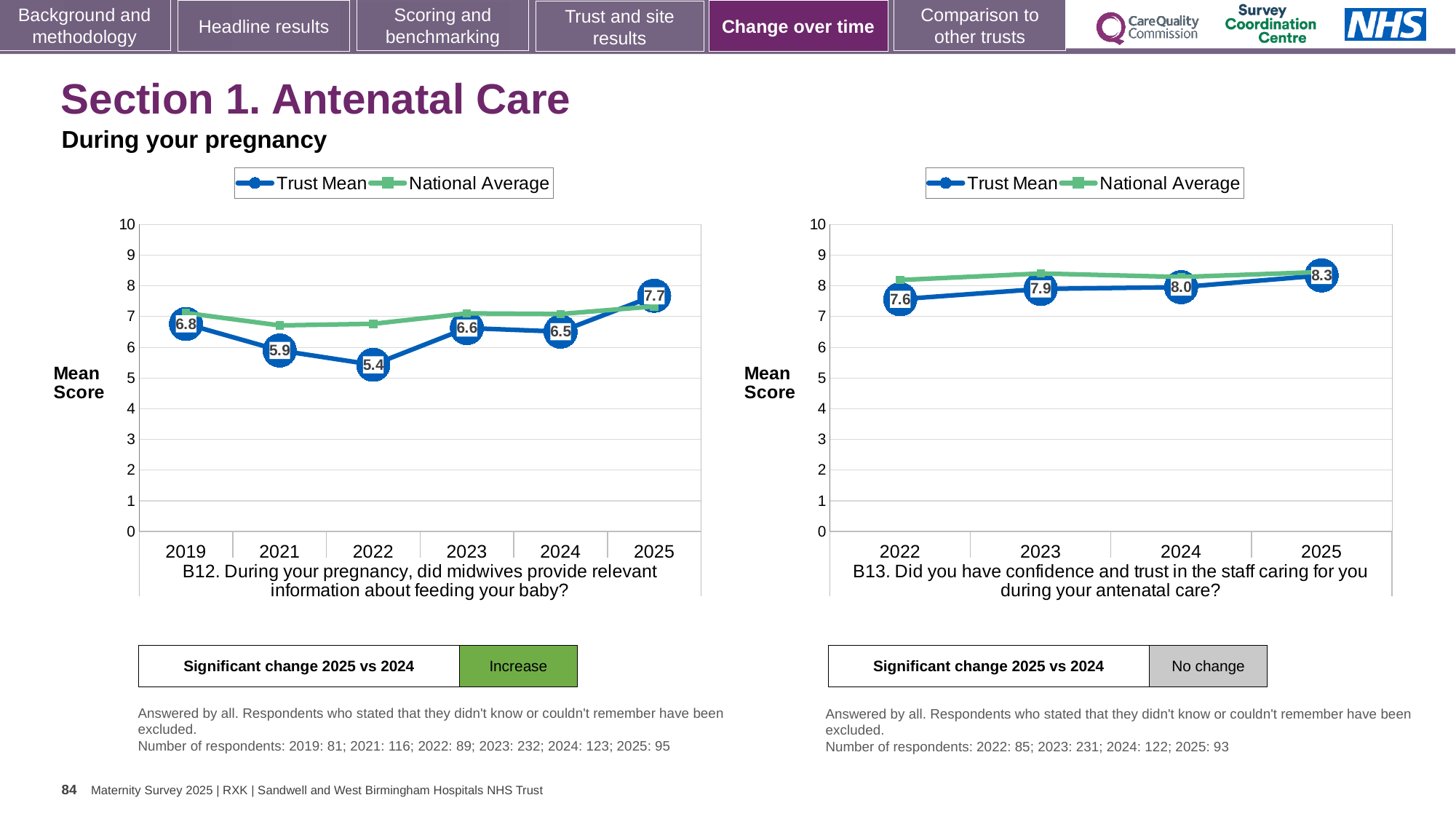
In the B12 chart (left), which year has the lowest Trust Mean score? 2022 How many series does the legend of the B13 chart (right) list? 2 In the B12 chart (left), what is the Trust Mean score for 2022? 5.4 In the B13 chart (right), what is the difference between the Trust Mean scores for 2025 and 2022? 0.7 How many years are plotted on the x axis of the B12 chart (left)? 6 In the B13 chart (right), which year has the highest Trust Mean score? 2025 What type of chart is used for the B13 chart (right)? Line chart In the B13 chart (right), is the National Average value for 2022 greater or less than 7? greater In the B12 chart (left), what is the difference between the Trust Mean scores for 2025 and 2024? 1.2 In the B13 chart (right), what is the Trust Mean score for 2022? 7.6 In the B12 chart (left), what is the Trust Mean score for 2025? 7.7 In the B12 chart (left), is the Trust Mean score higher in 2019 or in 2021? 2019